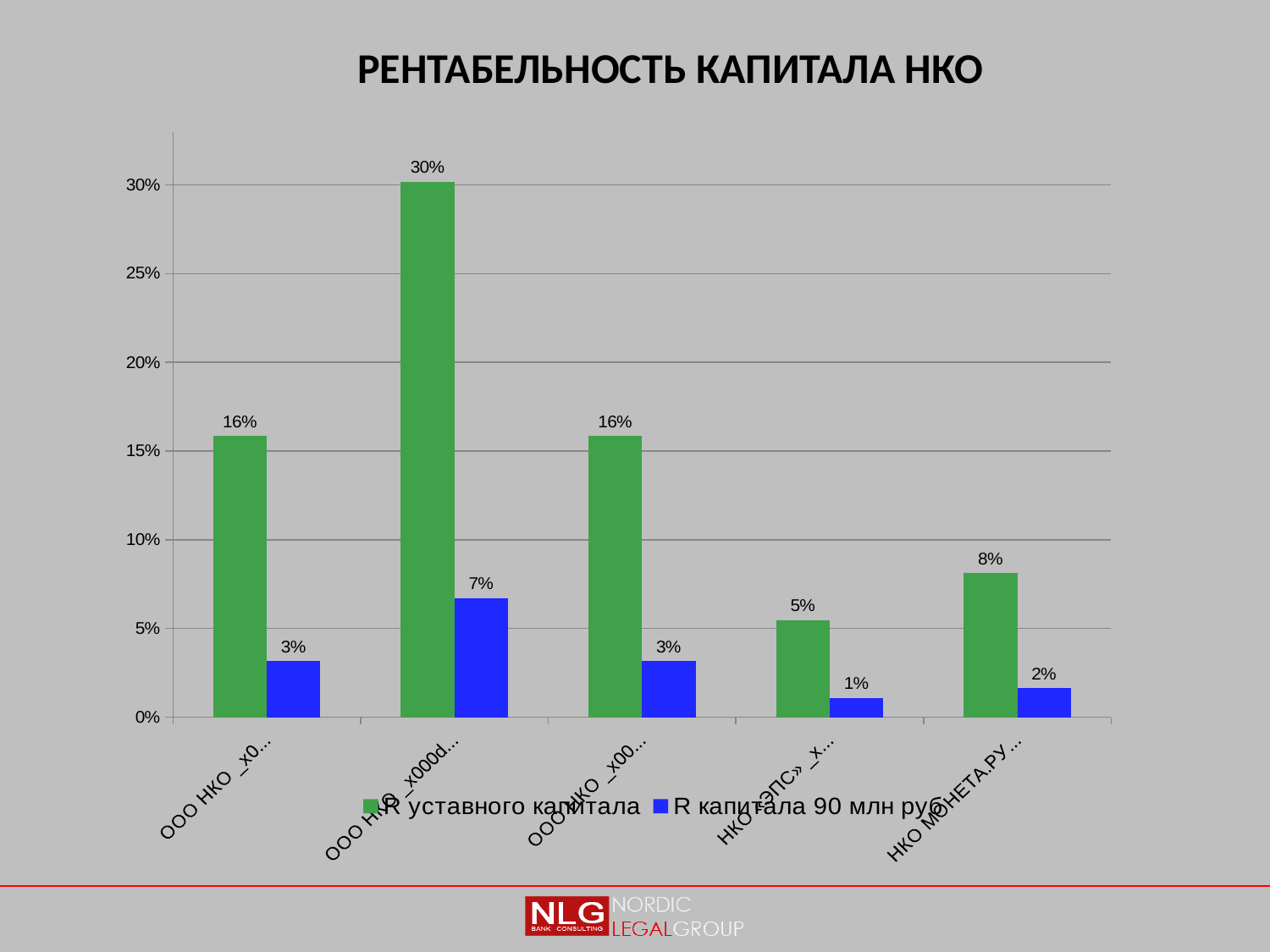
How many categories are shown on the x axis? 5 What is the value of "R капитала 90 млн руб" for the category labelled НКО «ЭПС»? 1% What is the value of "R уставного капитала" for the category labelled НКО МОНЕТА.РУ? 8% What is the difference between "R уставного капитала" and "R капитала 90 млн руб" for the second category from the left? 23% What is the value of "R капитала 90 млн руб" for the second category from the left? 7% Which category has the highest value of "R уставного капитала"? the second category from the left Which category has the lowest value of "R капитала 90 млн руб"? НКО «ЭПС» What is the value of "R уставного капитала" for the second category from the left? 30% What kind of chart is shown on the slide? bar chart For the category labelled НКО МОНЕТА.РУ, which is larger: "R уставного капитала" or "R капитала 90 млн руб"? R уставного капитала How many series does the legend list? 2 What is the title of the chart? РЕНТАБЕЛЬНОСТЬ КАПИТАЛА НКО